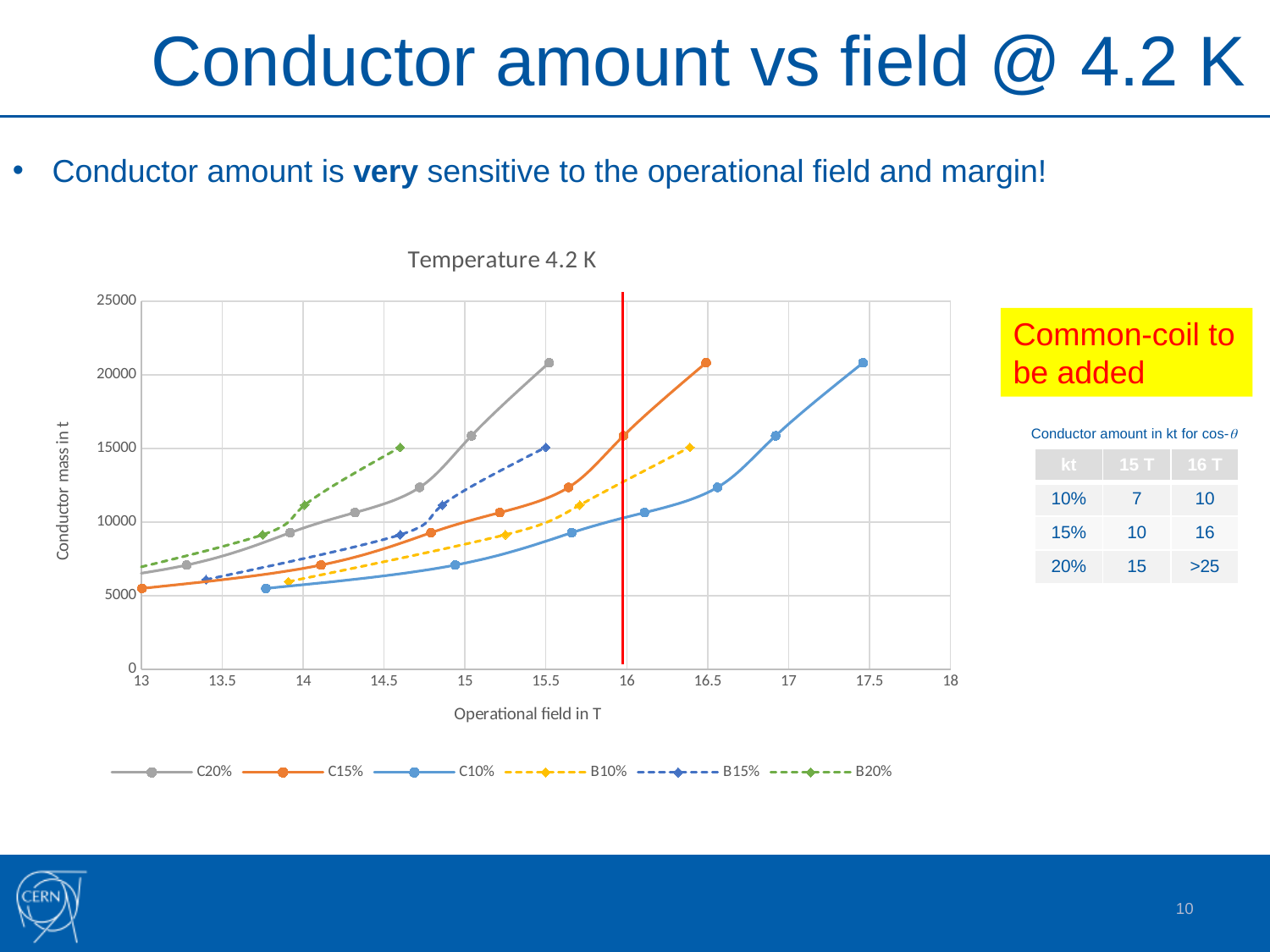
At an operational field of 14 T, which series has the larger conductor mass, C20% or C15%? C20% Is the value of the C10% series at 17.5 T greater or less than 20000? greater Is the highest value of the C20% series greater or less than 20000? greater What is the label of the x axis of the chart? Operational field in T Is the value of the C10% series at about 15.65 T greater or less than 10000? less Do the values of the C20% series rise or fall as the operational field increases? rise What is the title of the chart? Temperature 4.2 K Which series extends to the highest operational field on the chart? C10% How many series does the chart legend list? 6 What kind of chart is shown on the slide? line chart